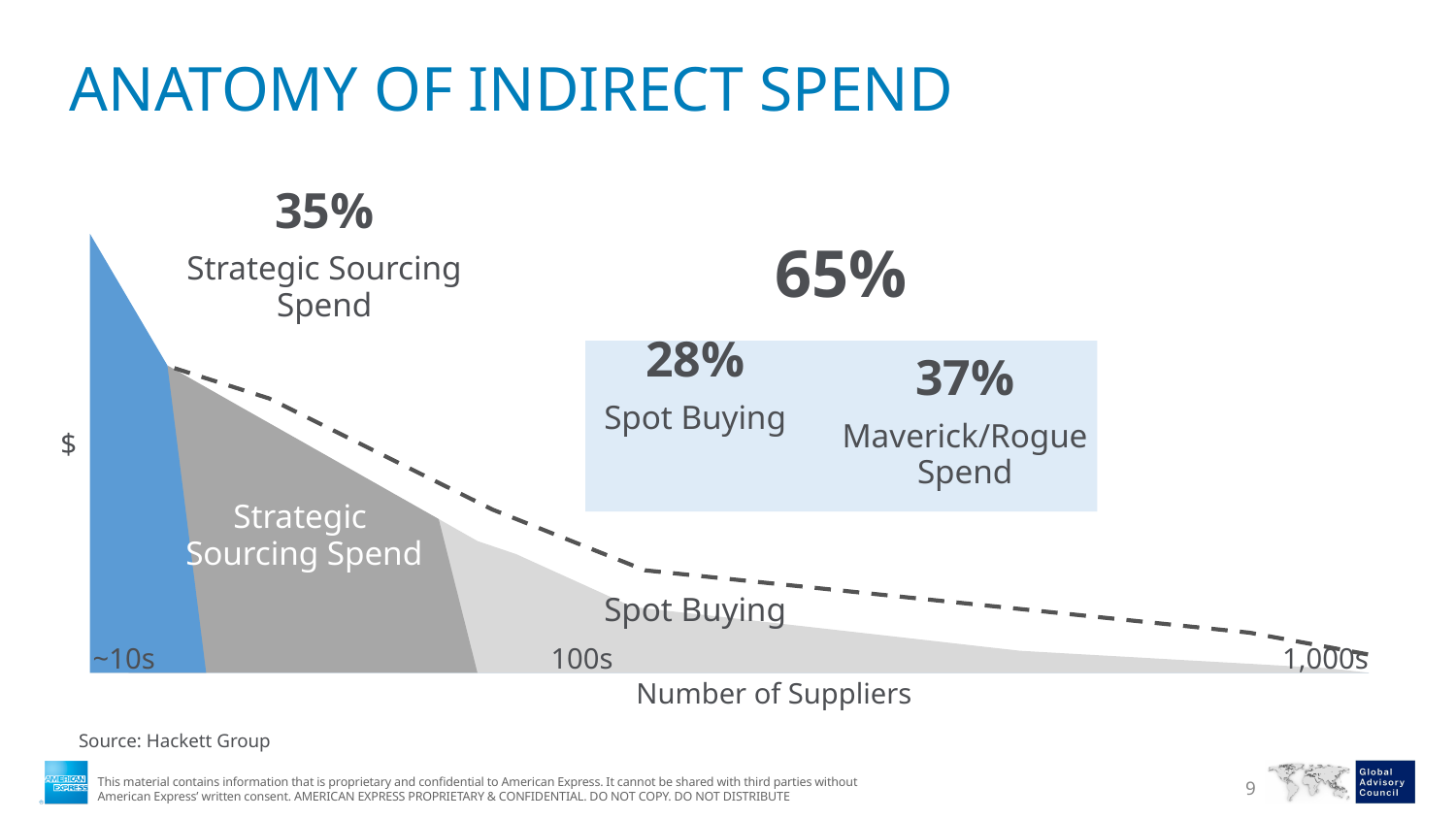
What is the difference in percentage points between Maverick/Rogue Spend and Spot Buying? 9 What is the label of the x axis? Number of Suppliers What is the source cited for the chart? Hackett Group What percentage of indirect spend is Strategic Sourcing Spend? 35% Which spend category has the largest percentage share? Maverick/Rogue Spend What combined percentage is shown for Spot Buying and Maverick/Rogue Spend together? 65% What percentage of indirect spend is Spot Buying? 28% How many spend categories are labelled with percentages in the chart? 3 What percentage of indirect spend is Maverick/Rogue Spend? 37% Which is larger, Strategic Sourcing Spend or Spot Buying? Strategic Sourcing Spend Which spend category has the smallest percentage share? Spot Buying Does the dollar value rise or fall as the number of suppliers increases along the x axis? fall